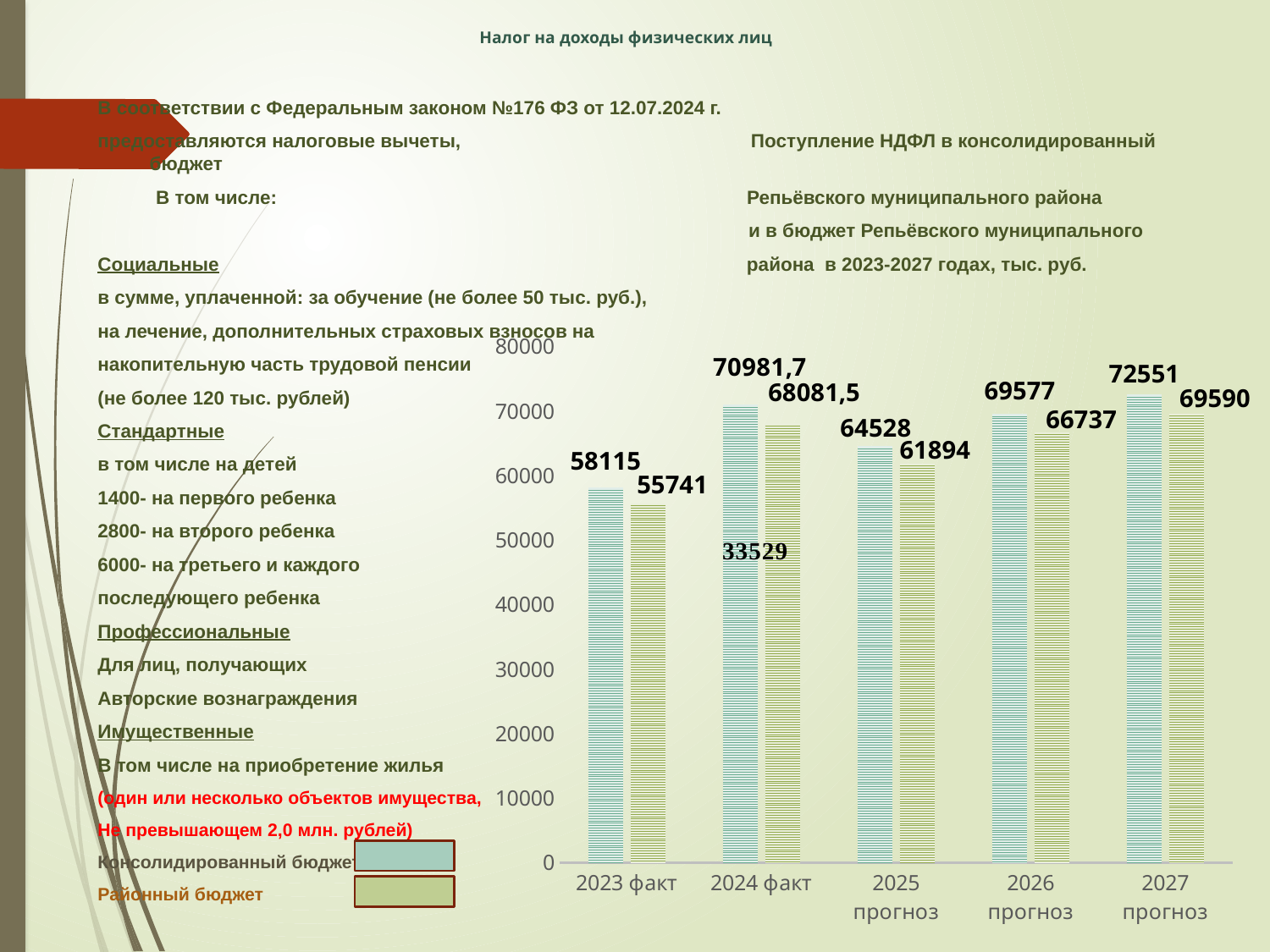
In which year is the district budget value the lowest? 2023 факт What type of chart is shown on the slide? bar chart In which year is the consolidated budget value the highest? 2027 прогноз What is the difference between the consolidated budget and the district budget in 2026 прогноз? 2840 How many years (categories) are shown on the x axis? 5 How many series does the chart's legend list? 2 What is the value for the consolidated budget in 2027 прогноз? 72551 What is the value for the consolidated budget (Консолидированный бюджет) in 2023 факт? 58115 What is the value for the district budget in 2025 прогноз? 61894 Which is larger: the consolidated budget in 2024 факт or the consolidated budget in 2025 прогноз? 2024 факт What is the value for the district budget (Районный бюджет) in 2024 факт? 68081,5 Which series is shown in green according to the legend? Районный бюджет